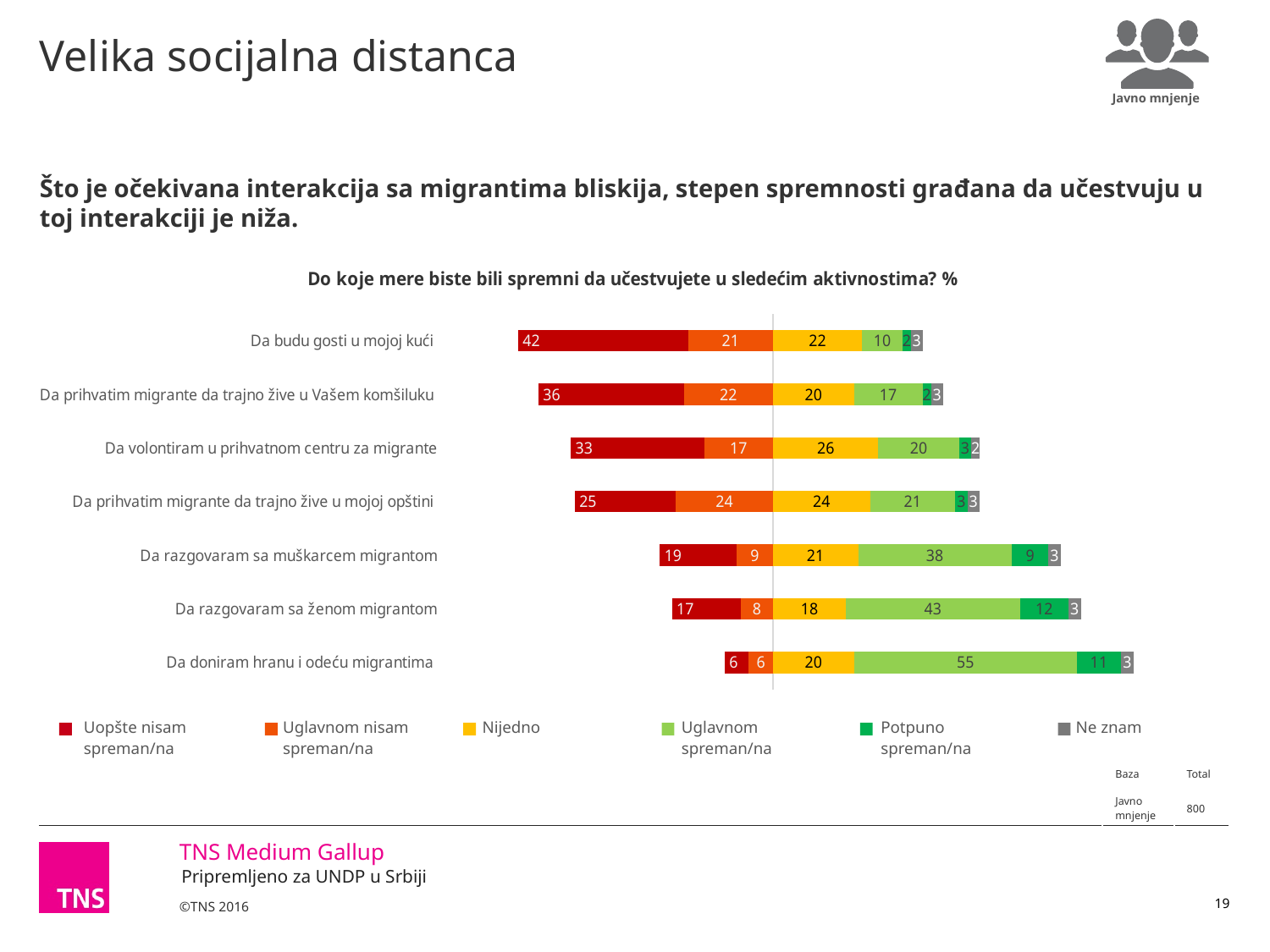
What is the value of "Uopšte nisam spreman/na" for "Da budu gosti u mojoj kući"? 42 What is the value of "Nijedno" for "Da volontiram u prihvatnom centru za migrante"? 26 What kind of chart is shown on the slide? Stacked bar chart How many activities (categories) are plotted in the chart? 7 How many series does the legend list? 6 What is the title of the chart? Do koje mere biste bili spremni da učestvujete u sledećim aktivnostima? % What is the value of "Potpuno spreman/na" for "Da razgovaram sa ženom migrantom"? 12 What is the value of "Uglavnom spreman/na" for "Da doniram hranu i odeću migrantima"? 55 Which is larger: the "Uglavnom spreman/na" value for "Da razgovaram sa muškarcem migrantom" or for "Da razgovaram sa ženom migrantom"? Da razgovaram sa ženom migrantom Which activity has the lowest value for "Uglavnom spreman/na"? Da budu gosti u mojoj kući What is the difference between the "Uopšte nisam spreman/na" values for "Da budu gosti u mojoj kući" and "Da prihvatim migrante da trajno žive u mojoj opštini"? 17 Which activity has the highest value for "Uopšte nisam spreman/na"? Da budu gosti u mojoj kući